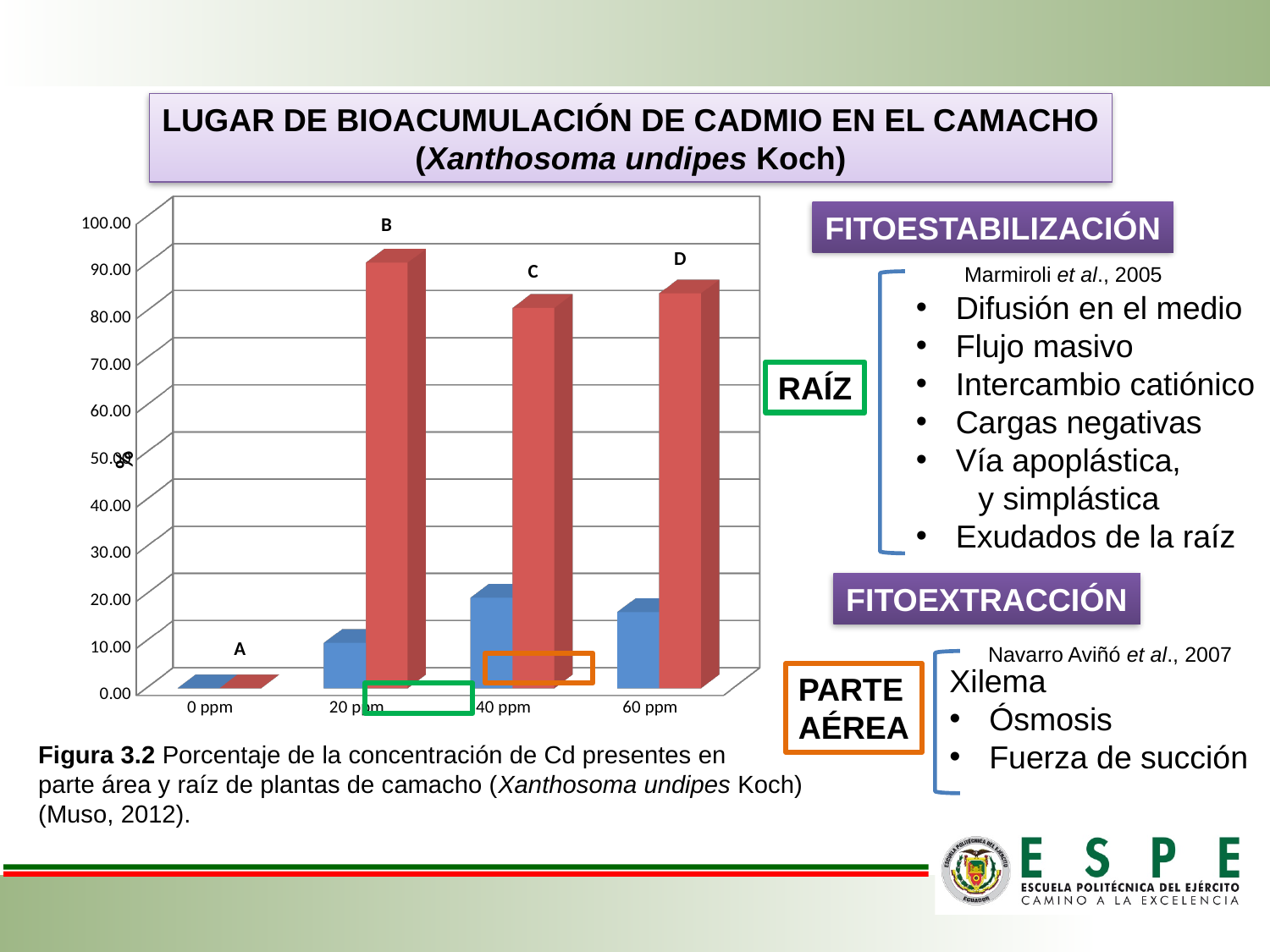
Do the blue bars rise or fall from 0 ppm to 40 ppm? rise Is the red bar at 40 ppm greater or less than 90? less What kind of chart is shown on the slide? bar chart How many categories are shown on the x axis of the chart? 4 What is the label on the y axis of the chart? % Is the red bar at 20 ppm greater or less than 80? greater At 40 ppm, which bar is larger, the red bar or the blue bar? the red bar Is the blue bar at 20 ppm greater or less than 20? less At which concentration is the red bar highest? 20 ppm At which concentration is the red bar lowest? 0 ppm Which letter labels the group of bars at 20 ppm? B